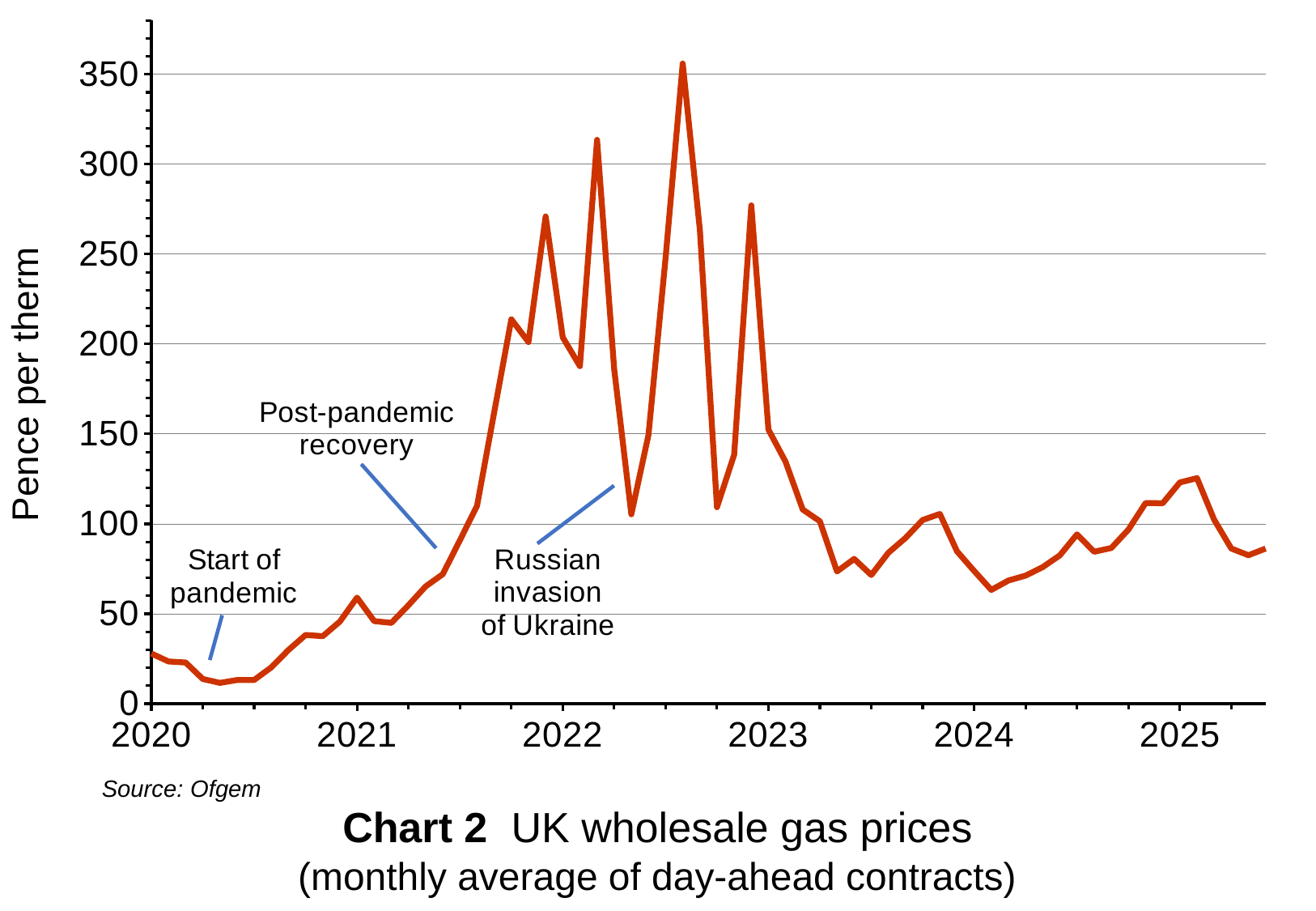
Is the highest peak of the line, in 2022, greater or less than 300 pence per therm? greater Is the value at the start of 2023 greater or less than 100 pence per therm? greater Does the line generally rise or fall between the start of 2021 and the start of 2022? Rise In which year does the line reach its highest point? 2022 Is the value at the start of 2024 greater or less than 100 pence per therm? less Which of the two is higher: the value at the start of 2020 or the value at the start of 2025? The value at the start of 2025 Does the line generally rise or fall between the start of 2023 and the start of 2024? Fall What kind of chart is shown on the slide? Line chart What is the title of the chart? Chart 2 UK wholesale gas prices (monthly average of day-ahead contracts) What is the label on the vertical axis of the chart? Pence per therm